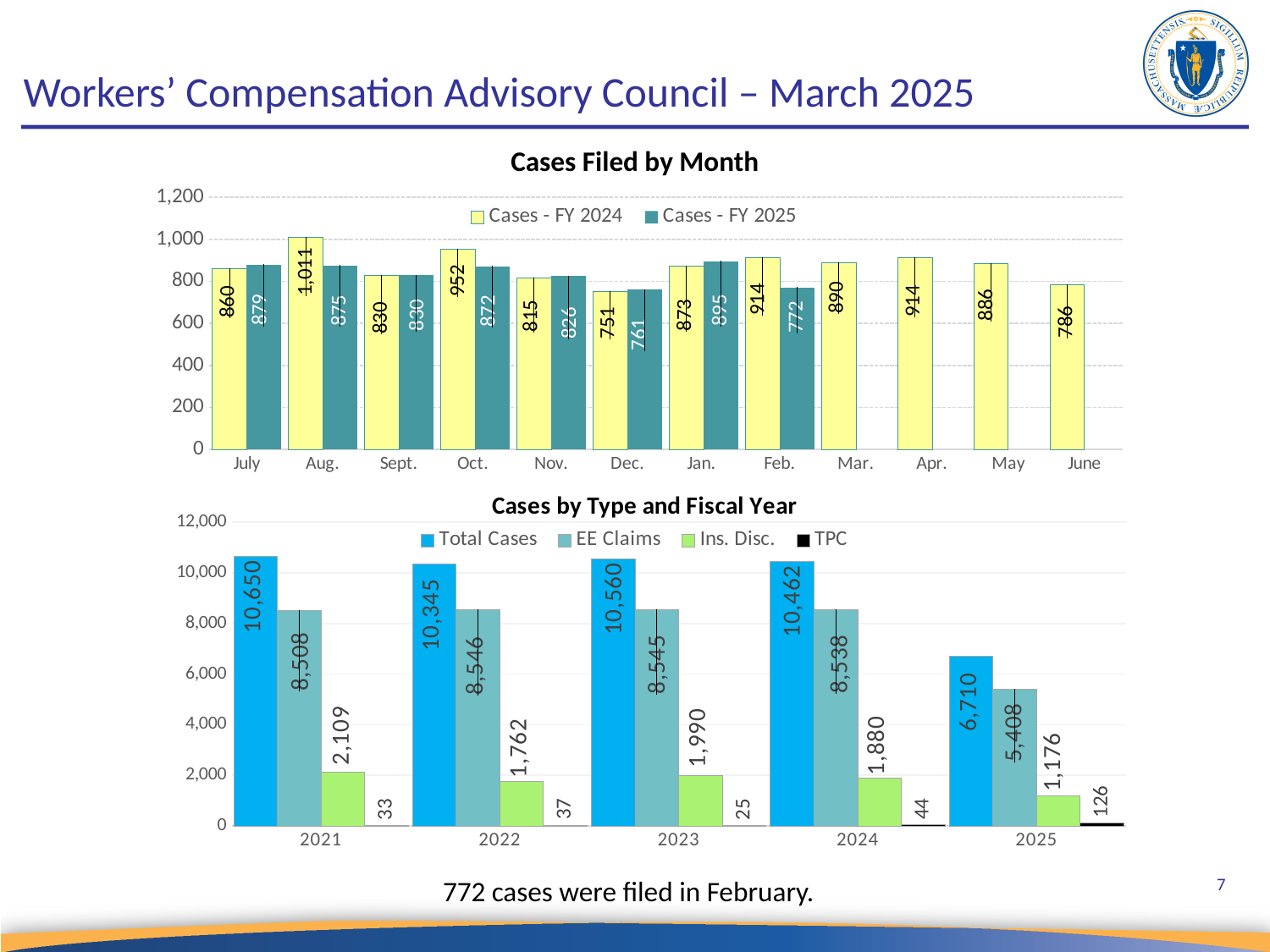
In the 'Cases Filed by Month' chart, which is larger in January: Cases - FY 2024 or Cases - FY 2025? Cases - FY 2025 In the 'Cases Filed by Month' chart, what is the value for Cases - FY 2025 in February? 772 In the 'Cases Filed by Month' chart, how many series does the legend list? 2 In the 'Cases by Type and Fiscal Year' chart, how many years are shown on the x axis? 5 What kind of chart is 'Cases by Type and Fiscal Year'? Bar chart In the 'Cases Filed by Month' chart, what is the difference between Cases - FY 2024 and Cases - FY 2025 in October? 80 In the 'Cases Filed by Month' chart, which month has the lowest value for Cases - FY 2025? Dec. In the 'Cases by Type and Fiscal Year' chart, what is the value for EE Claims in 2023? 8,545 In the 'Cases by Type and Fiscal Year' chart, what is the difference between Total Cases in 2024 and Total Cases in 2025? 3,752 In the 'Cases by Type and Fiscal Year' chart, which year has the highest value for Total Cases? 2021 In the 'Cases Filed by Month' chart, which month has the highest value for Cases - FY 2024? Aug. In the 'Cases by Type and Fiscal Year' chart, which year has the highest value for TPC? 2025